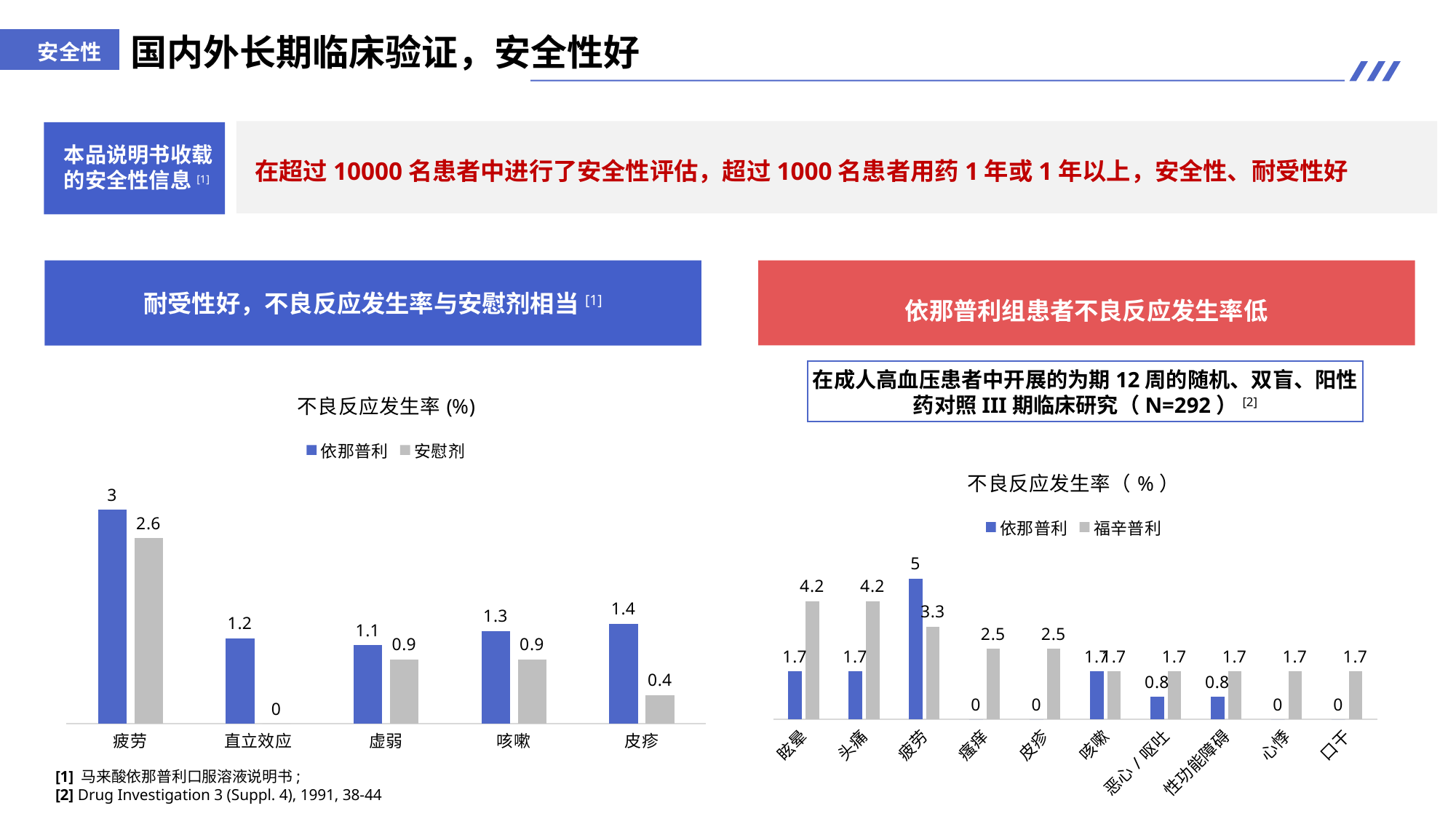
In the right chart, what is the value for 依那普利 in the 疲劳 category? 5 In the right chart, which is larger for 头痛: the 依那普利 value or the 福辛普利 value? 福辛普利 In the right chart, what is the difference between the 福辛普利 and 依那普利 values for 眩晕? 2.5 In the left chart, how many categories are shown on the x axis? 5 In the left chart, which category has the highest value for 依那普利? 疲劳 In the right chart, which category has the highest value for 依那普利? 疲劳 In the left chart, what is the difference between the 依那普利 and 安慰剂 values for 皮疹? 1 In the right chart, how many categories are shown on the x axis? 10 In the left chart, what is the value for 依那普利 in the 疲劳 category? 3 In the left chart, what is the value for 安慰剂 in the 皮疹 category? 0.4 In the right chart, what is the value for 福辛普利 in the 眩晕 category? 4.2 What type of chart is the right chart? Bar chart